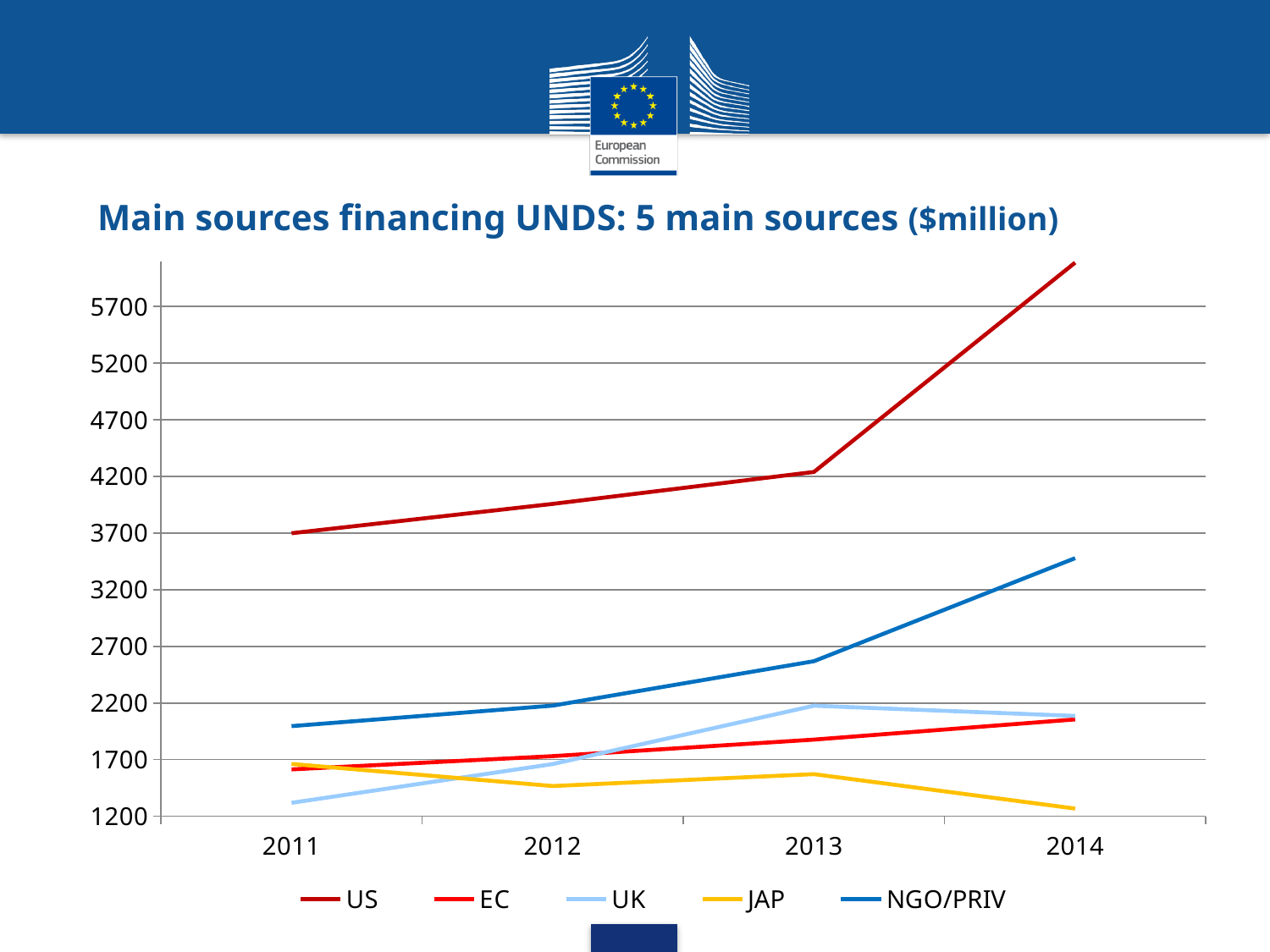
What kind of chart is shown on the slide? line chart In 2013, which is larger, the value for UK or the value for EC? UK Is the value for US in 2014 greater or less than 5700? greater Does the US line rise or fall from 2011 to 2014? rise Is the value for UK in 2011 greater or less than 1700? less Which source has the highest value in 2014? US Which source has the lowest value in 2014? JAP Is the value for NGO/PRIV in 2014 greater or less than 3200? greater How many series does the legend list? 5 How many years are shown on the x axis? 4 What is the title of the chart? Main sources financing UNDS: 5 main sources ($million)